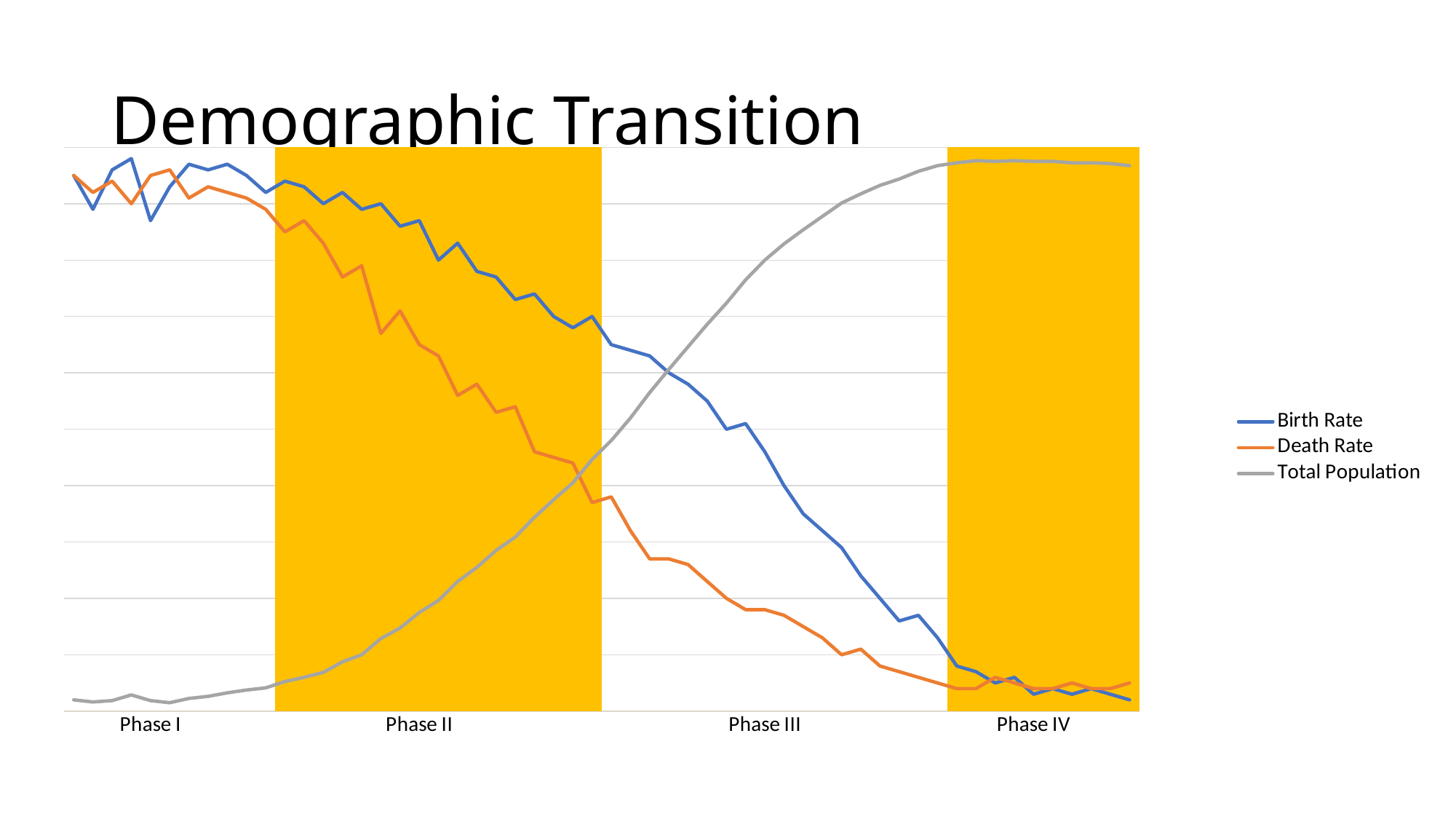
Does the Total Population line rise or fall from Phase I to Phase IV? Rise What kind of chart is shown on the slide? Line chart In the middle of Phase III, which is higher: Birth Rate or Death Rate? Birth Rate In Phase I, which is higher: Birth Rate or Total Population? Birth Rate In Phase IV, which is higher: Total Population or Birth Rate? Total Population Which series is at its lowest in Phase I? Total Population How many phases are labelled along the x axis? 4 Does the Birth Rate line rise or fall from Phase II to Phase IV? Fall How many series does the legend list? 3 What is the title of the chart? Demographic Transition Does the Death Rate line rise or fall across Phase II? Fall Which series is drawn in orange? Death Rate